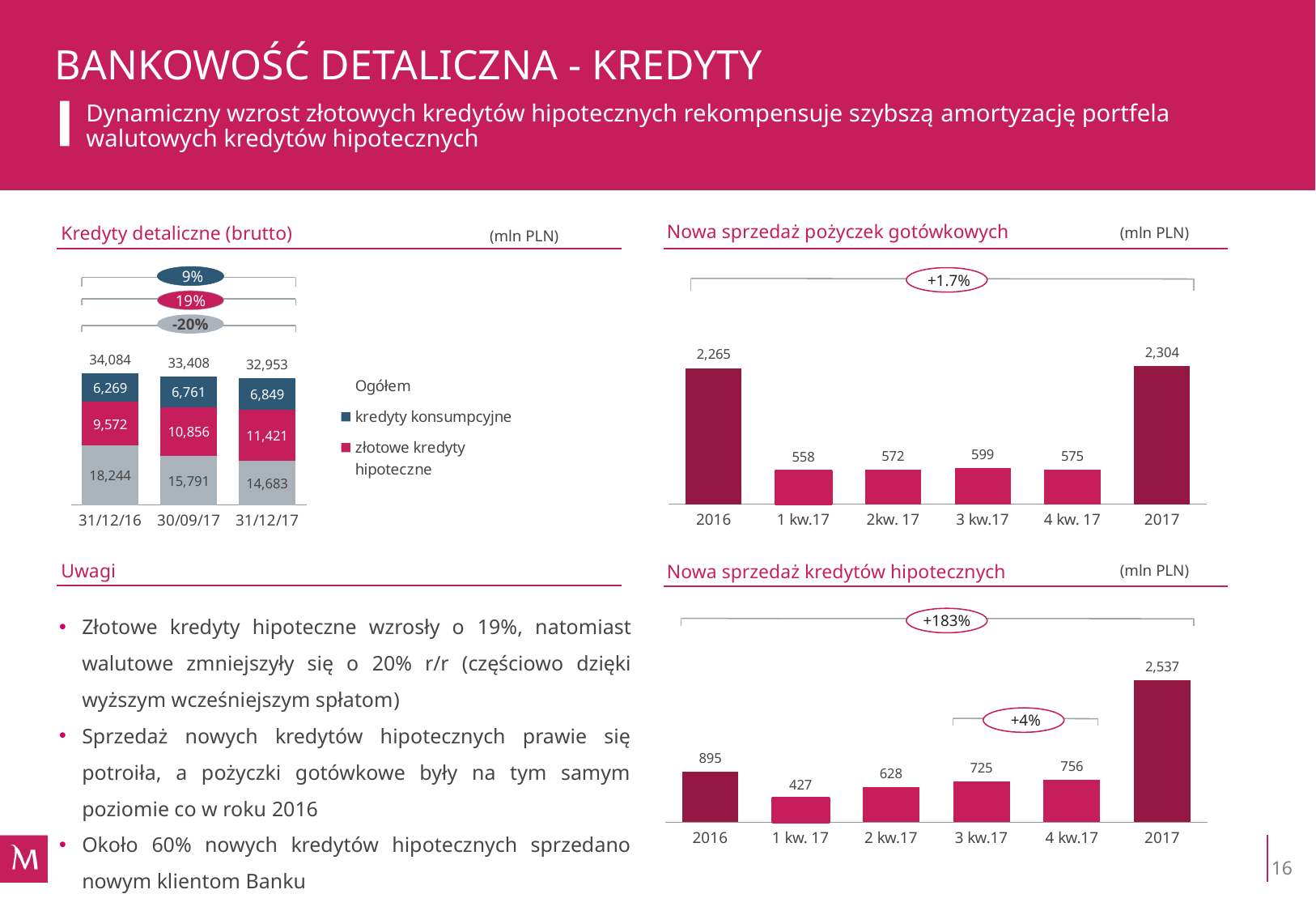
In the 'Nowa sprzedaż pożyczek gotówkowych' chart, which quarter of 2017 has the highest value? 3 kw.17 In the 'Kredyty detaliczne (brutto)' chart, what is the total shown for 31/12/16? 34,084 In the 'Nowa sprzedaż pożyczek gotówkowych' chart, how many bars are plotted? 6 In the 'Nowa sprzedaż pożyczek gotówkowych' chart, what is the value for 2017? 2,304 In the 'Nowa sprzedaż kredytów hipotecznych' chart, do the quarterly values rise or fall from 1 kw. 17 to 4 kw.17? rise In the 'Nowa sprzedaż kredytów hipotecznych' chart, which category has the lowest value? 1 kw. 17 In the 'Kredyty detaliczne (brutto)' chart, what is the value of złotowe kredyty hipoteczne at 31/12/17? 11,421 In the 'Nowa sprzedaż kredytów hipotecznych' chart, what percentage change is shown between 2016 and 2017? +183% In the 'Nowa sprzedaż pożyczek gotówkowych' chart, what is the difference between the 2017 and 2016 values? 39 What kind of chart is 'Kredyty detaliczne (brutto)'? stacked bar chart In the 'Nowa sprzedaż kredytów hipotecznych' chart, what is the value for 1 kw. 17? 427 In the 'Nowa sprzedaż kredytów hipotecznych' chart, what is the difference between the 2017 and 2016 values? 1,642